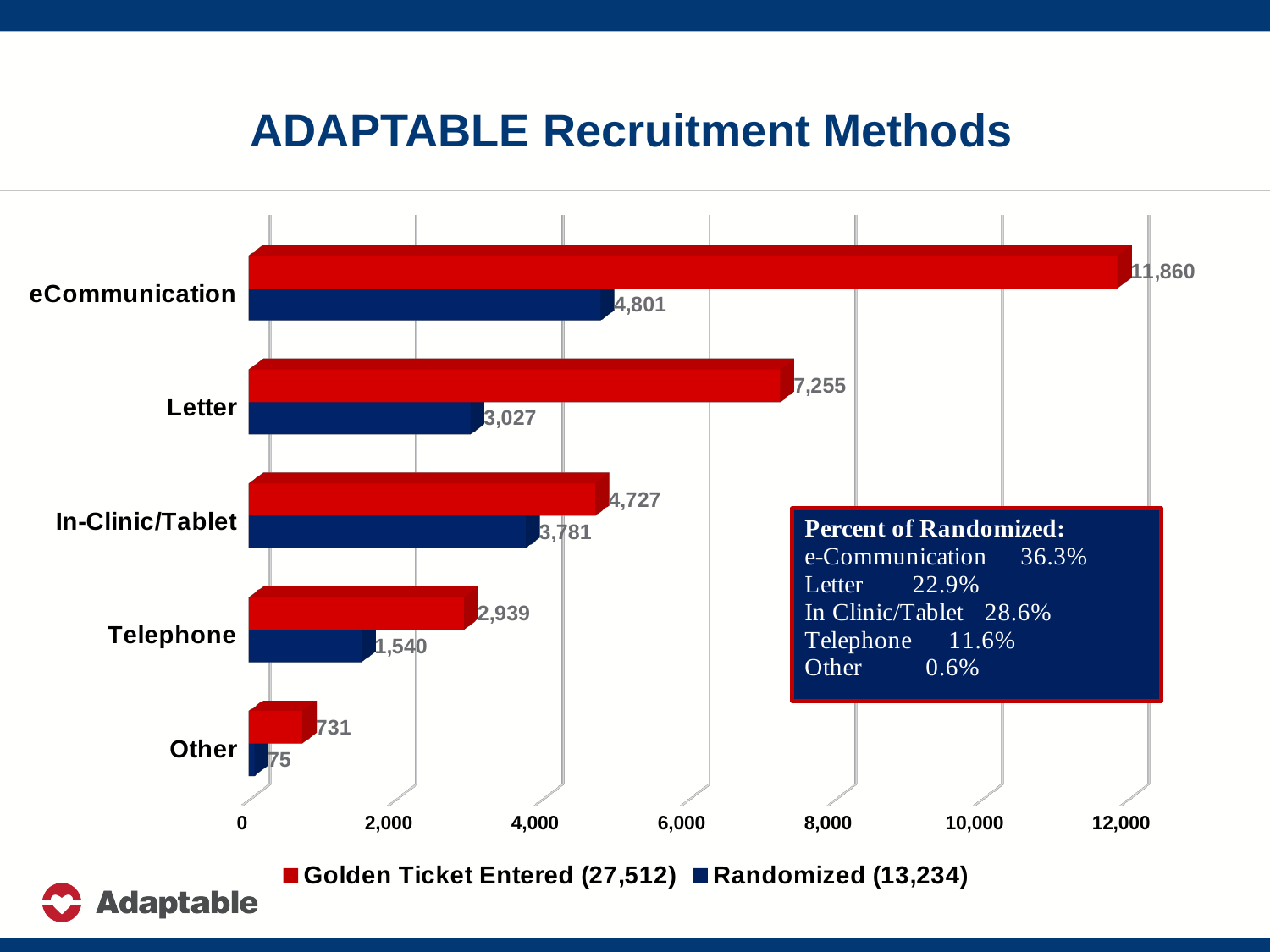
What is the Randomized value for Letter? 3,027 Which recruitment method has the highest Golden Ticket Entered value? eCommunication How many recruitment methods are shown on the chart? 5 What is the difference between the Golden Ticket Entered and Randomized values for In-Clinic/Tablet? 946 What is the Randomized value for Telephone? 1,540 Is the Golden Ticket Entered value for Letter greater or less than 6,000? greater What type of chart is shown on the slide? Bar chart What is the Golden Ticket Entered value for eCommunication? 11,860 Which is larger: the Randomized value for eCommunication or the Golden Ticket Entered value for In-Clinic/Tablet? Randomized value for eCommunication How many series does the legend list? 2 What is the title of the chart? ADAPTABLE Recruitment Methods Which recruitment method has the lowest Randomized value? Other